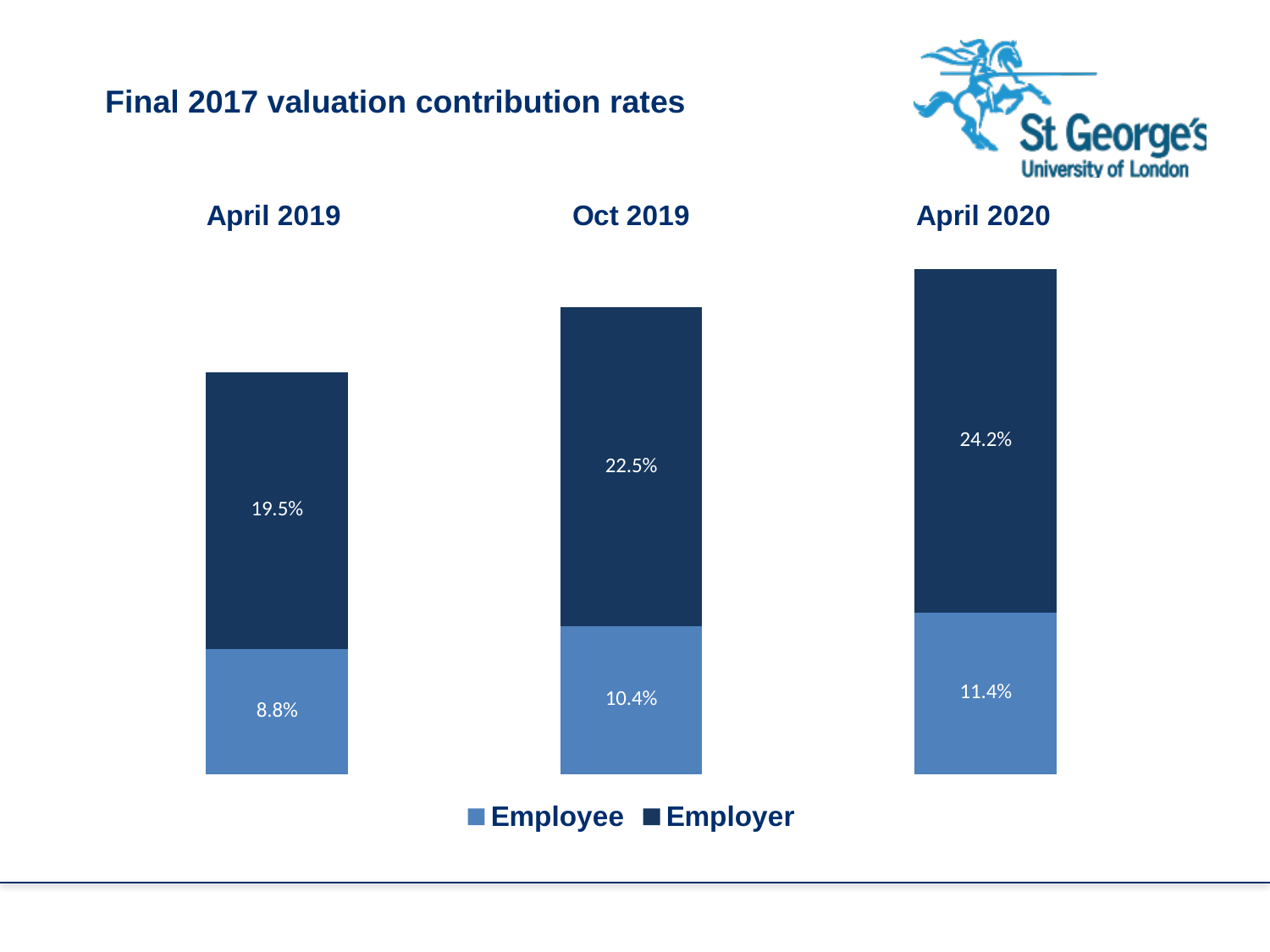
What is the Employer contribution rate for Oct 2019? 22.5% Is the Employee rate for April 2020 larger or smaller than the Employee rate for Oct 2019? larger What is the Employer contribution rate for April 2020? 24.2% Which period has the lowest Employee contribution rate? April 2019 How many series does the legend list? 2 Which period has the highest Employer contribution rate? April 2020 What kind of chart is shown on the slide? Stacked bar chart What is the Employee contribution rate for April 2019? 8.8% What is the difference between the Employer rate in April 2020 and the Employer rate in April 2019? 4.7% How many periods are shown on the chart? 3 What is the total contribution rate (Employee plus Employer) for Oct 2019? 32.9% What is the Employee contribution rate for Oct 2019? 10.4%